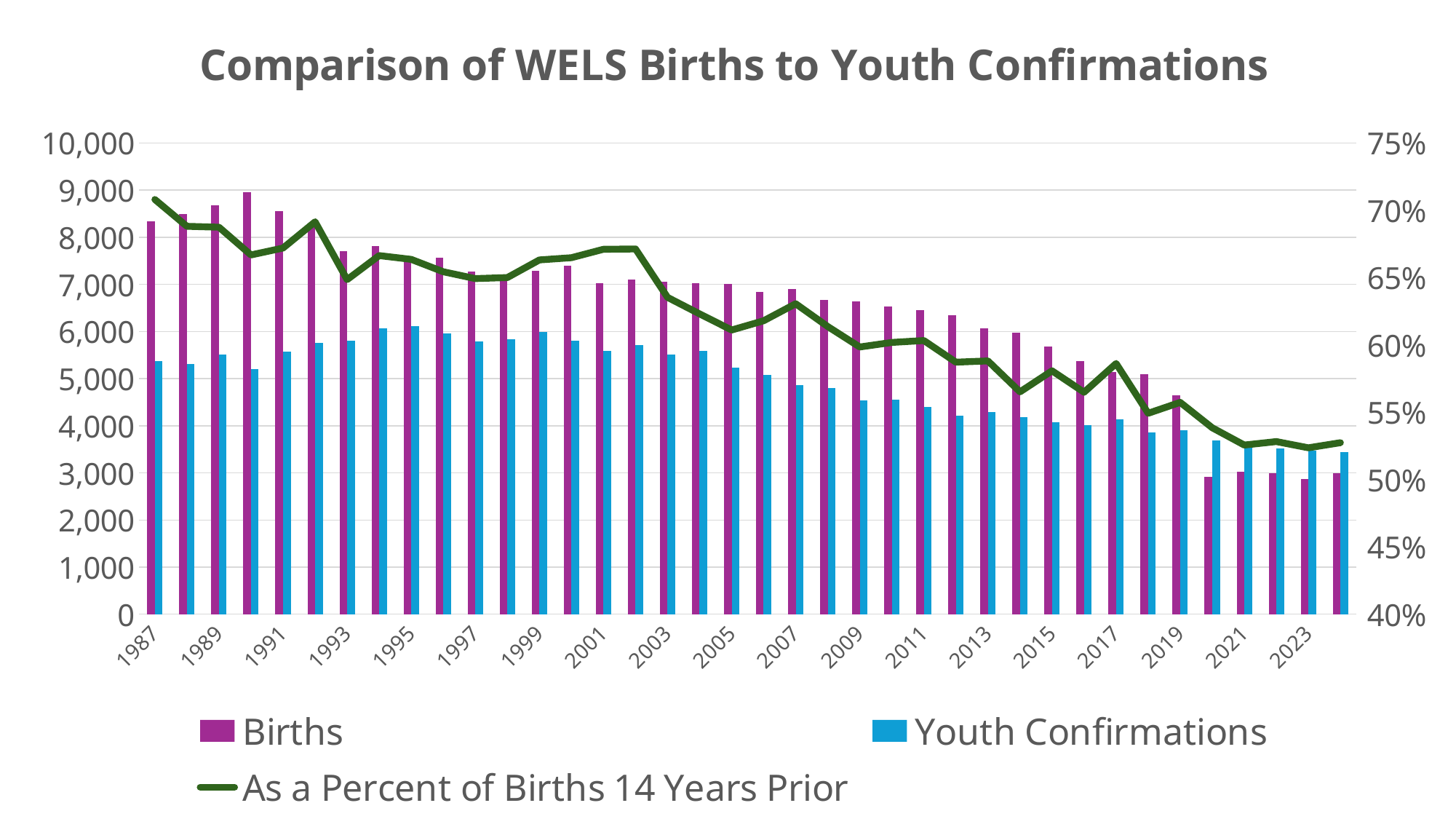
How many years are plotted along the x axis? 38 What is the title of the chart? Comparison of WELS Births to Youth Confirmations Do the Births values generally rise or fall from 1987 to 2023? fall Is the value for Births in 2023 greater or less than 3,000? less How many series does the legend list? 3 What kind of chart is this? Bar chart with a line series Which year has the highest value for As a Percent of Births 14 Years Prior? 1987 Is the value for Youth Confirmations in 1987 greater or less than 5,000? greater Is the value for As a Percent of Births 14 Years Prior in 1987 greater or less than 70%? greater Which year has the highest value for Births? 1990 In 1987, which is larger, Births or Youth Confirmations? Births